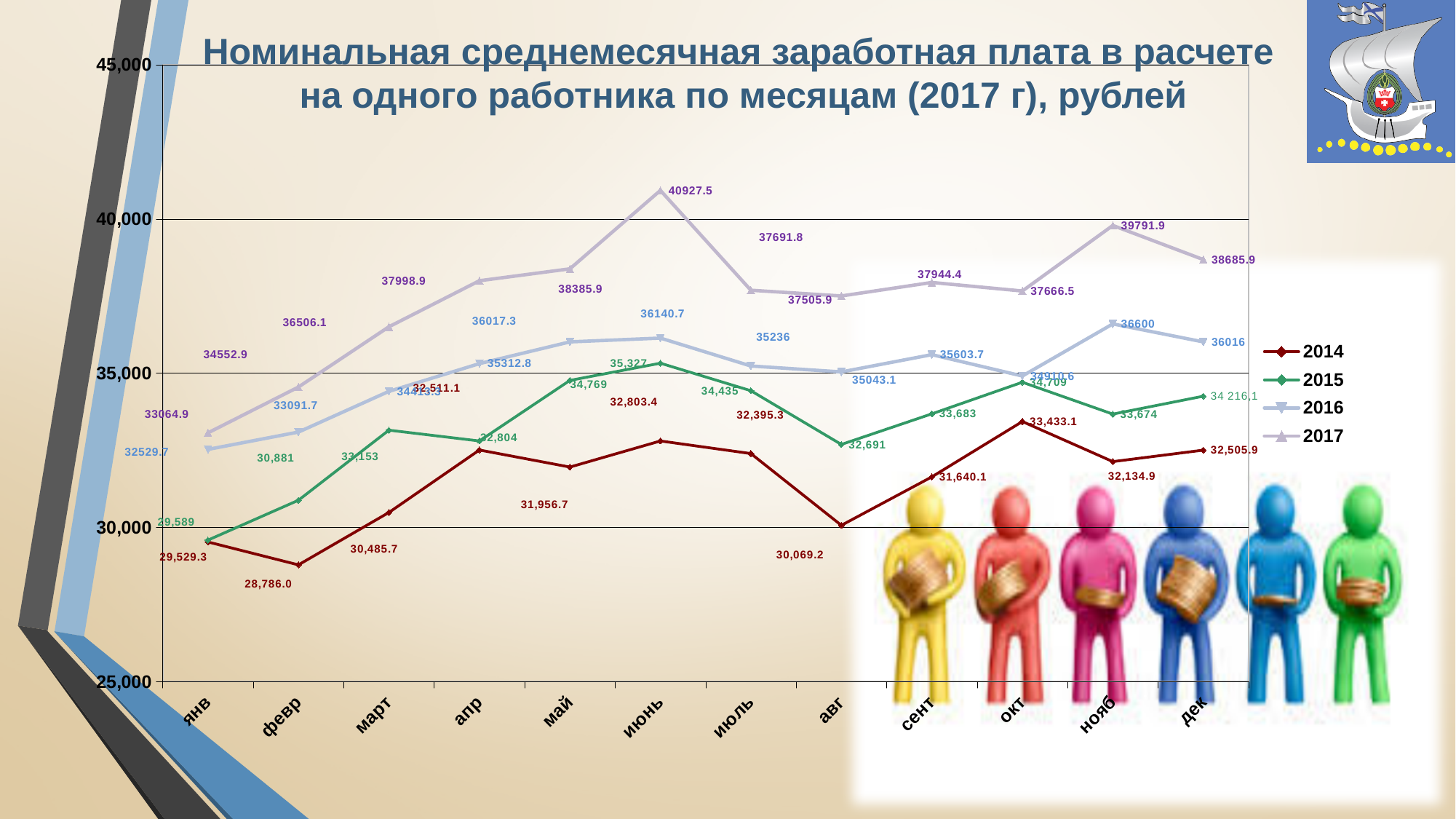
What is the difference between the 2017 values for нояб and дек? 1106.0 How many months are plotted along the x axis? 12 In which month does the 2014 series have its lowest value? февр What is the value for 2017 in июнь? 40927.5 What kind of chart is shown on the slide? line chart Is the value for 2017 in июнь greater or less than 40,000? greater Does the 2017 series rise or fall from янв to июнь? rise What is the value for 2016 in нояб? 36600 In which month does the 2017 series reach its highest value? июнь How many series does the legend list? 4 Which is larger in июнь: the 2015 value or the 2016 value? 2016 Which years are listed in the legend? 2014, 2015, 2016, 2017